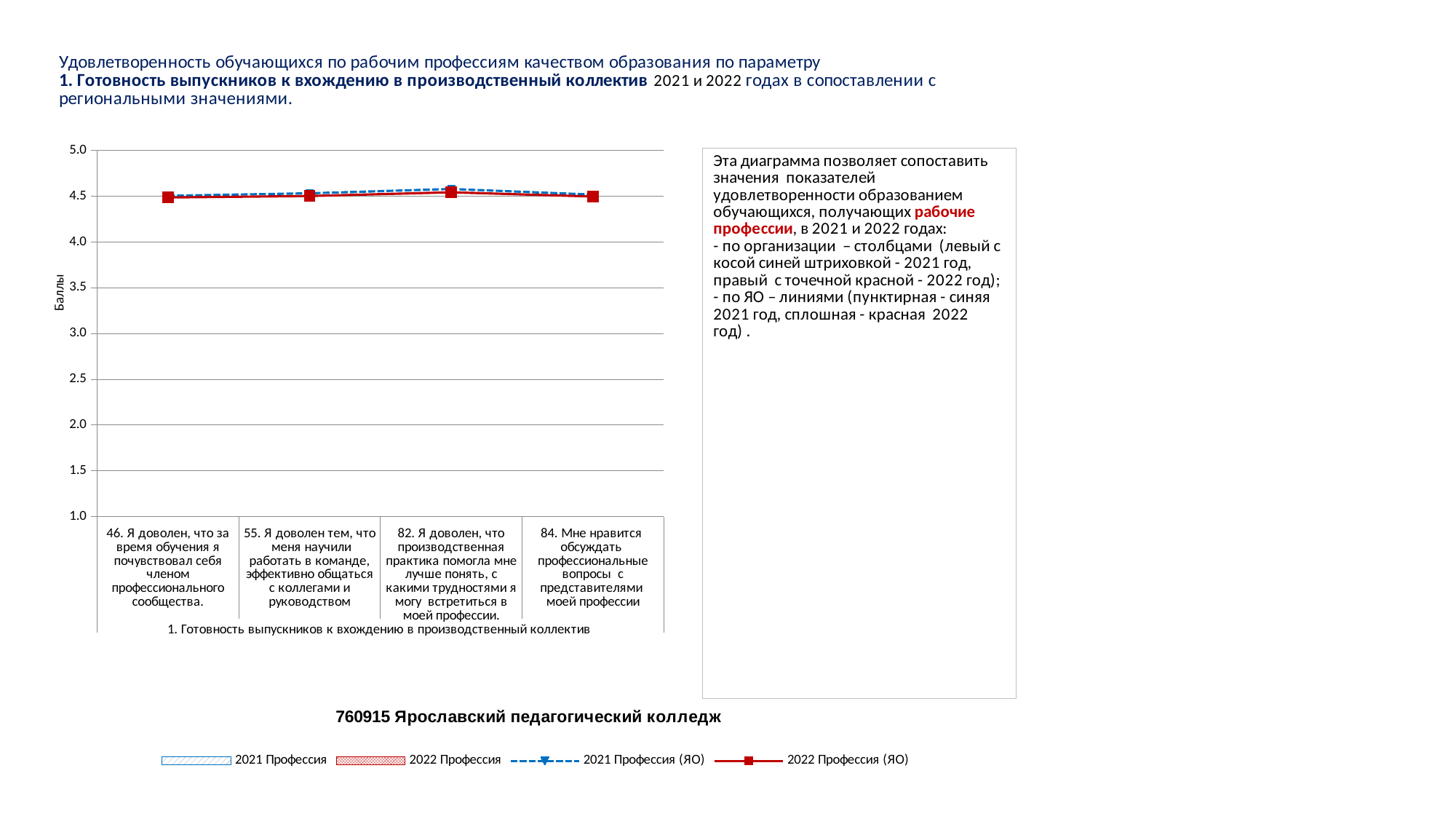
Is the value of the 2022 Профессия (ЯО) line for category 46 greater or less than 4.0? greater What is the label of the vertical axis of the chart? Баллы How many categories are shown on the x axis of the chart? 4 Is the value of the 2022 Профессия (ЯО) line for category 84 greater or less than 3.0? greater How many series does the chart legend list? 4 What is the title printed below the chart? 760915 Ярославский педагогический колледж Is the value of the 2021 Профессия (ЯО) line for category 82 greater or less than 5.0? less What is the lowest value shown on the vertical axis of the chart? 1.0